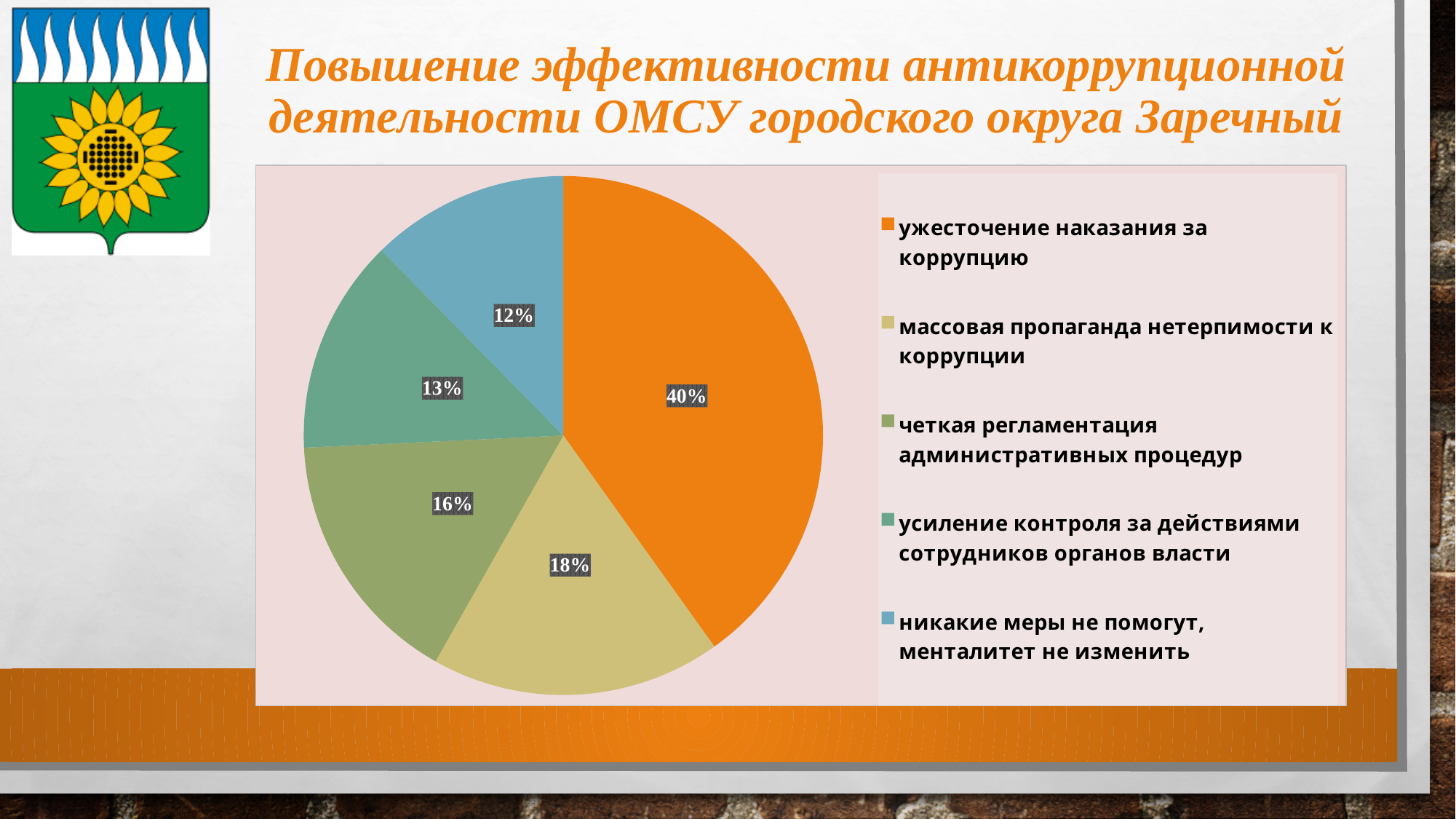
What type of chart is shown on the slide? pie chart What share is given to "никакие меры не помогут, менталитет не изменить"? 12% What value is labelled on the slice for "четкая регламентация административных процедур"? 16% Which category has the smallest slice of the pie? никакие меры не помогут, менталитет не изменить What colour is the slice for "ужесточение наказания за коррупцию"? orange What percentage is shown for "массовая пропаганда нетерпимости к коррупции"? 18% Which legend entry is shown with a blue marker? никакие меры не помогут, менталитет не изменить How many slices does the pie chart have? 5 What share of the pie does "ужесточение наказания за коррупцию" have? 40% What is the difference in percentage points between "ужесточение наказания за коррупцию" and "массовая пропаганда нетерпимости к коррупции"? 22 Which is larger: the slice for "усиление контроля за действиями сотрудников органов власти" or the slice for "четкая регламентация административных процедур"? четкая регламентация административных процедур Which category has the largest slice of the pie? ужесточение наказания за коррупцию